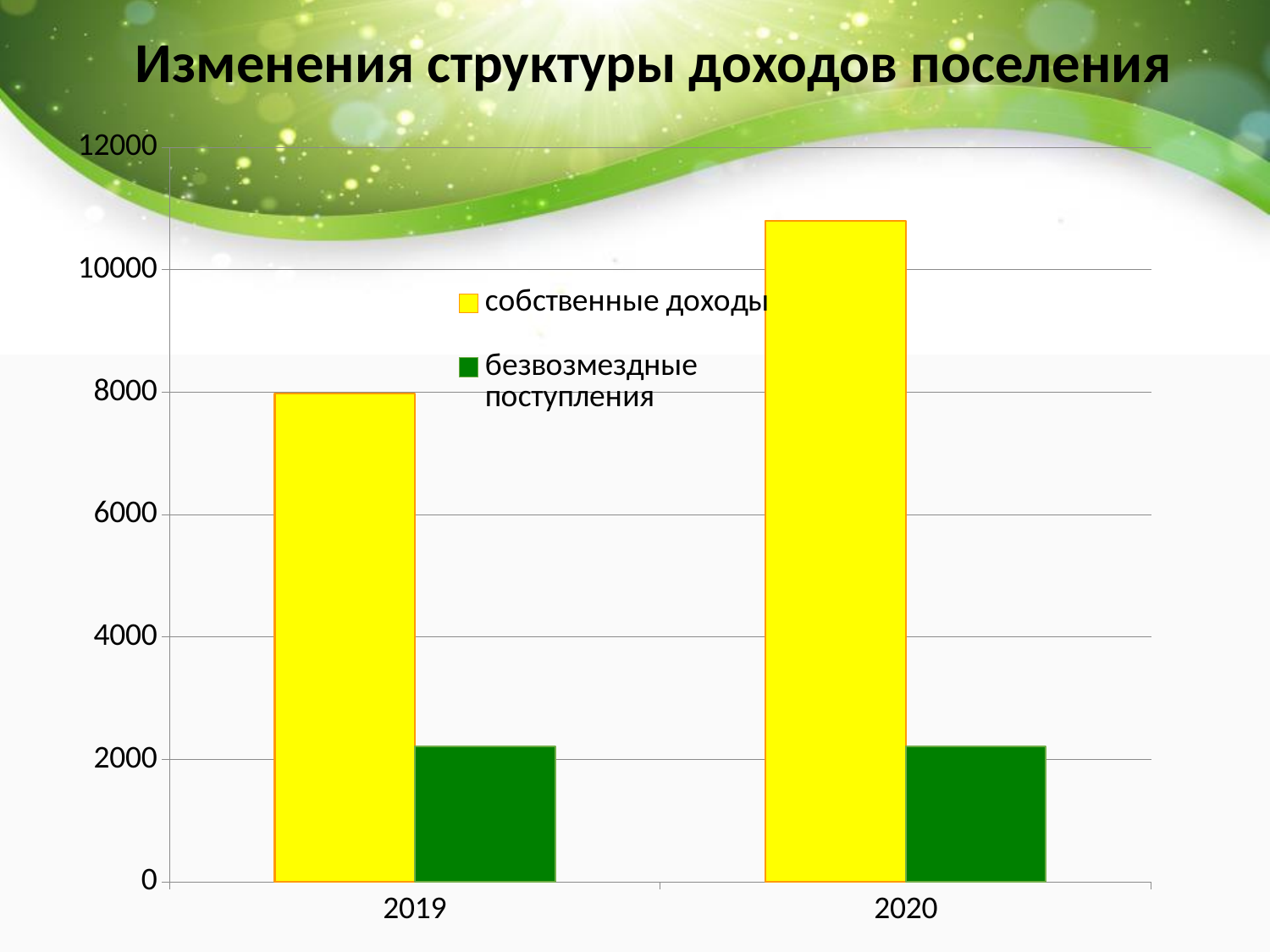
Is the value for безвозмездные поступления in 2020 greater or less than 4000? less Which series is shown in yellow? собственные доходы How many years are shown on the x axis? 2 In 2019, which is larger: собственные доходы or безвозмездные поступления? собственные доходы What is the title of the chart? Изменения структуры доходов поселения How many series does the legend list? 2 Which bar is the highest on the chart? собственные доходы in 2020 Is the value for собственные доходы in 2020 greater or less than 10000? greater Do собственные доходы rise or fall from 2019 to 2020? rise What kind of chart is shown on the slide? bar chart Is the value for собственные доходы in 2019 greater or less than 6000? greater